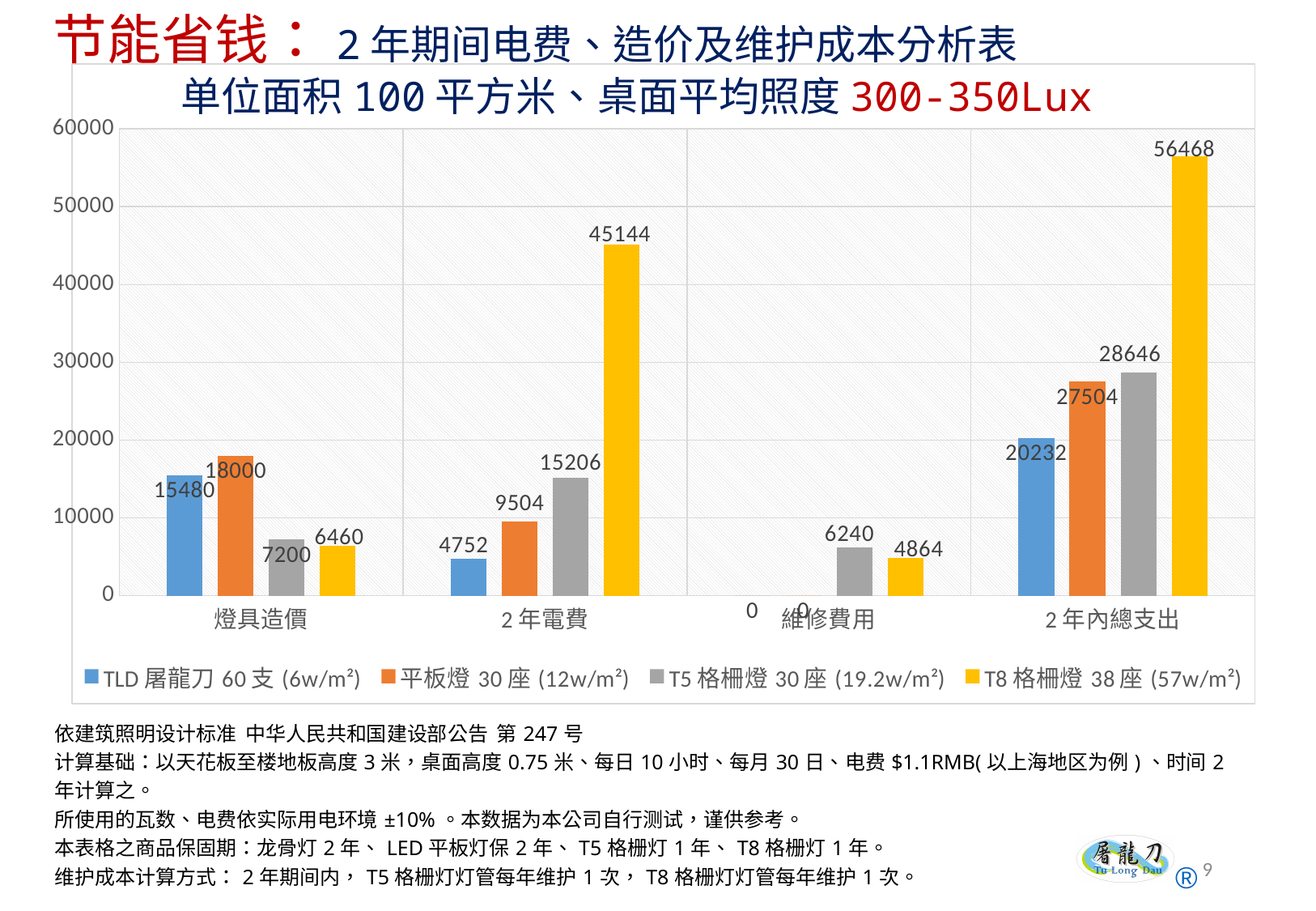
What is the value for T5 格柵燈 30座 in the 維修費用 category? 6240 Which series has the lowest value in the 2年內總支出 category? TLD 屠龍刀 60支 (6w/m²) What is the value for TLD 屠龍刀 60支 in the 2年內總支出 category? 20232 What type of chart is shown on the slide? bar chart Is the value for T8 格柵燈 38座 in the 2年內總支出 category greater or less than 50000? greater What colour are the bars for T8 格柵燈 38座? yellow How many categories are shown on the x axis? 4 Which series has the highest value in the 燈具造價 category? 平板燈 30座 (12w/m²) In the 2年電費 category, which is larger: the value for 平板燈 30座 or the value for T5 格柵燈 30座? T5 格柵燈 30座 (19.2w/m²) How many series does the legend list? 4 What is the difference between the 2年內總支出 values for T8 格柵燈 38座 and TLD 屠龍刀 60支? 36236 What is the value for T8 格柵燈 38座 in the 2年電費 category? 45144